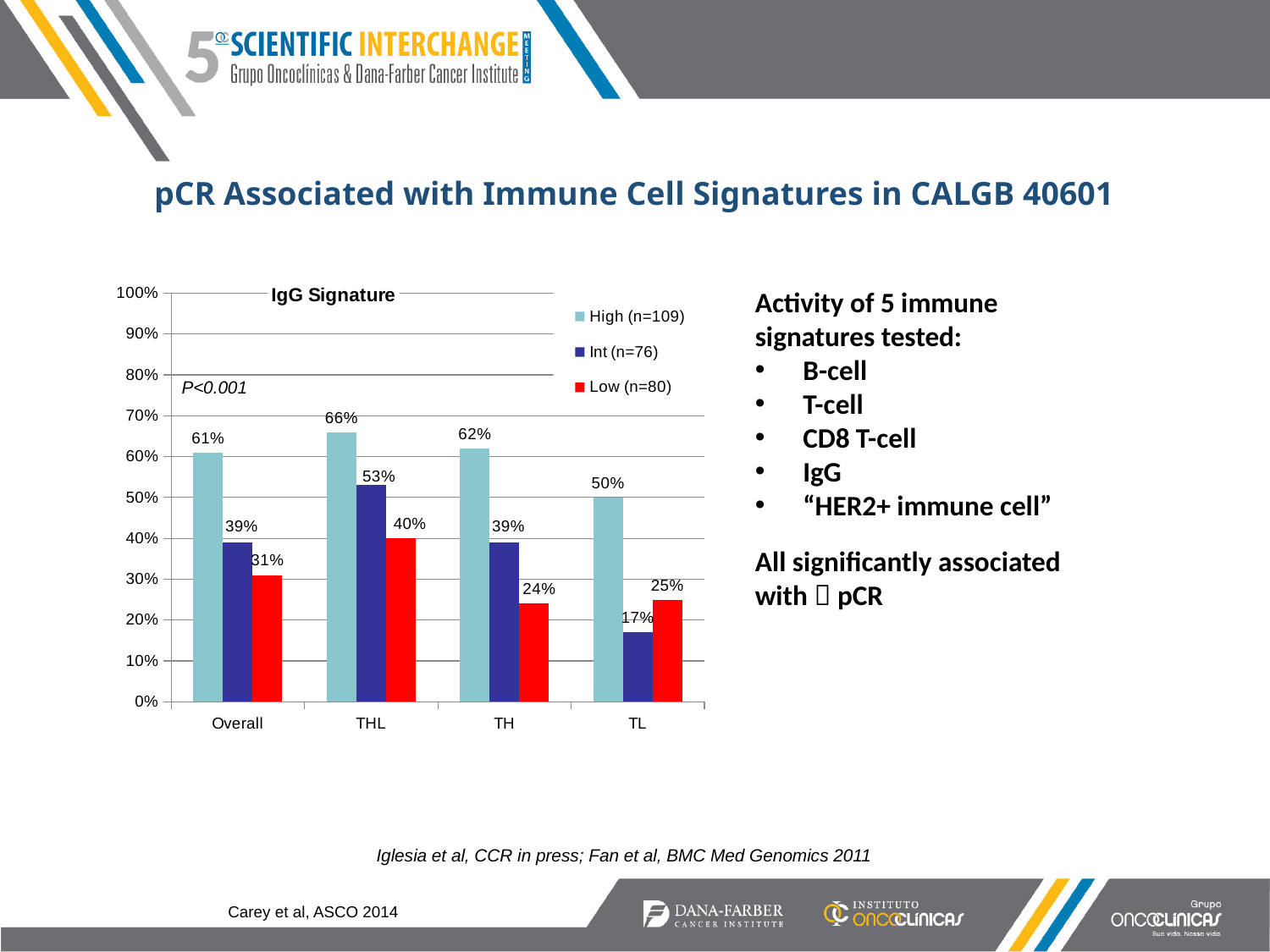
How many series does the legend list? 3 How many categories are shown on the x axis? 4 Which category has the lowest value for the Int (n=76) series? TL What is the difference between the High (n=109) and Low (n=80) values in the THL category? 26% What is the value for High (n=109) in the Overall category? 61% What is the value for Int (n=76) in the TL category? 17% Which category has the highest value for the High (n=109) series? THL What is the value for Low (n=80) in the TH category? 24% What kind of chart is shown on the slide? bar chart Which is larger in the TL category: the Int (n=76) value or the Low (n=80) value? Low (n=80) What is the title of the chart? IgG Signature Is the value for High (n=109) in the TH category greater or less than 50%? greater